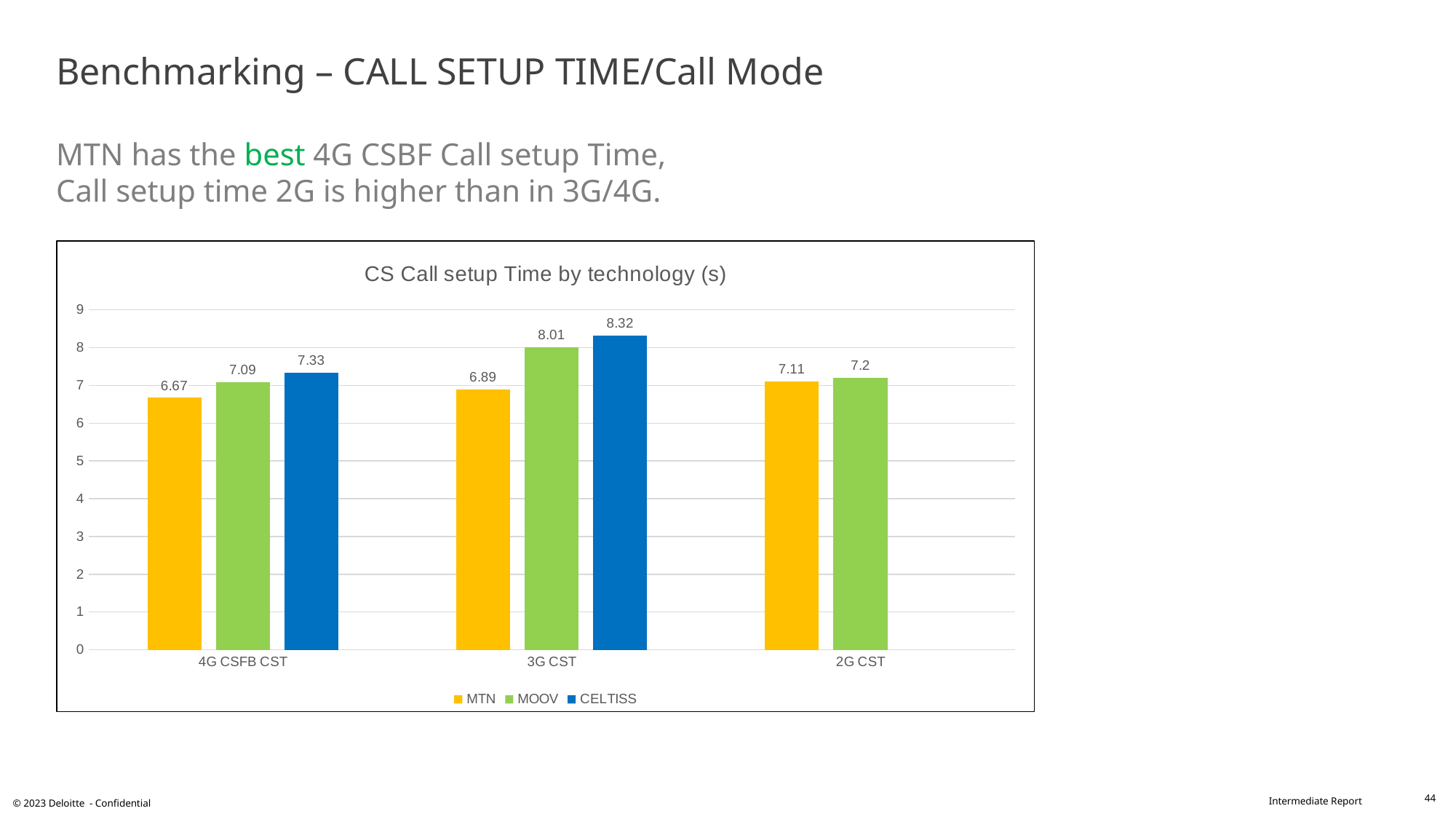
What is the MTN value for 4G CSFB CST? 6.67 How many categories are shown on the x axis? 3 Which is larger, the MOOV value for 3G CST or the MOOV value for 2G CST? MOOV value for 3G CST What is the difference between the CELTISS and MTN values for 3G CST? 1.43 How many series does the legend list? 3 Which operator has the highest call setup time for 3G CST? CELTISS What is the title of the chart? CS Call setup Time by technology (s) What is the MOOV value for 2G CST? 7.2 What is the CELTISS value for 3G CST? 8.32 What kind of chart is shown on the slide? Bar chart Is the CELTISS value for 4G CSFB CST greater or less than 7? greater Which operator has the lowest call setup time for 4G CSFB CST? MTN